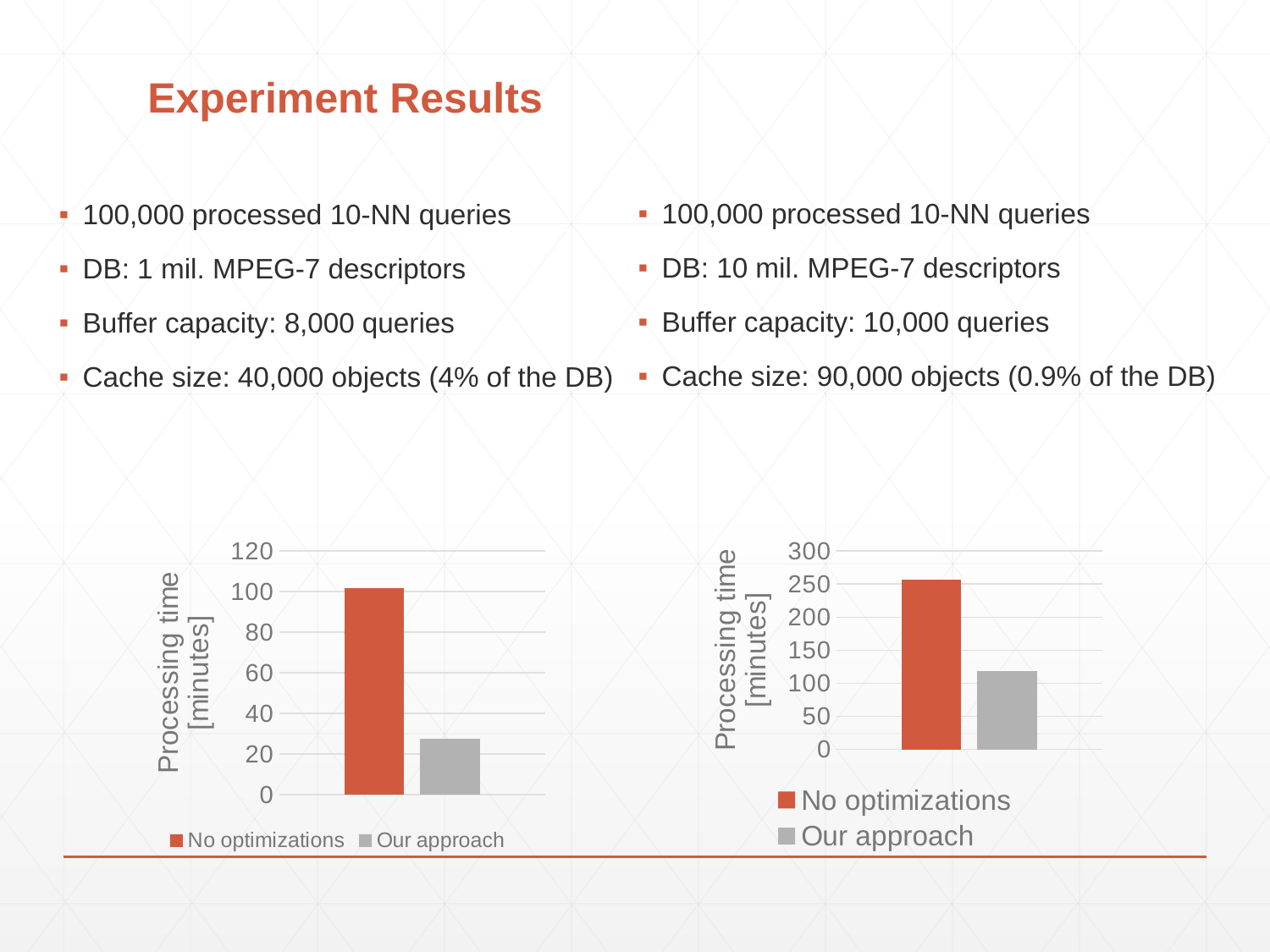
How many bars are plotted in the left chart? 2 How many series does the legend of the right chart list? 2 What is the y-axis label of the left chart? Processing time [minutes] In the left chart, is the value for Our approach greater or less than 40? less In the right chart, which series has the highest value? No optimizations What kind of chart is the left chart on the slide? bar chart In the right chart, which series has the lowest value? Our approach In the right chart, is the value for Our approach greater or less than 150? less What are the two legend entries of the right chart? No optimizations, Our approach In the right chart, is the value for No optimizations greater or less than 200? greater In the left chart, which series has the taller bar, No optimizations or Our approach? No optimizations